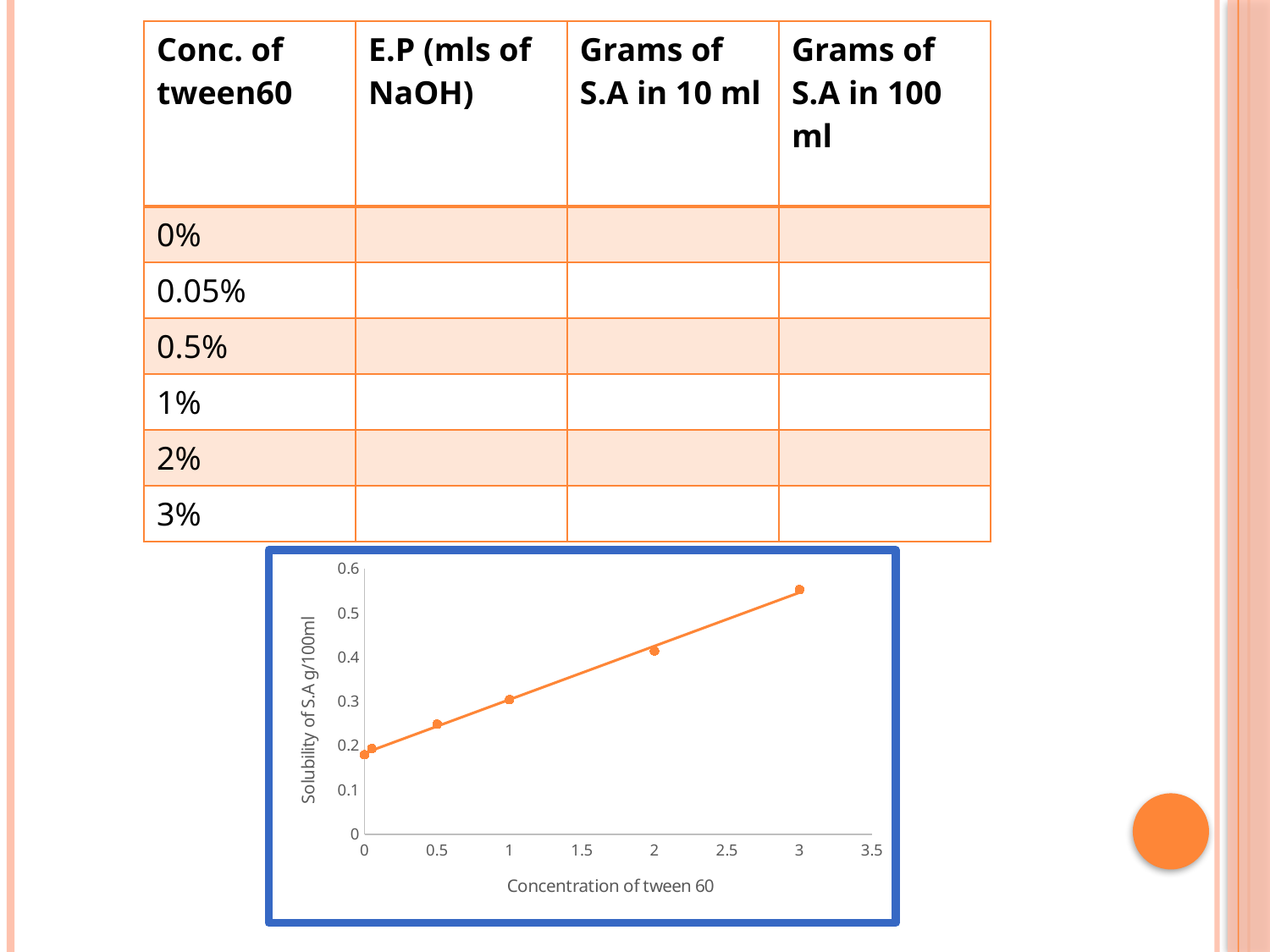
Is the solubility value at a tween 60 concentration of 3 greater or less than 0.5? greater Is the solubility value at a tween 60 concentration of 1 greater or less than 0.4? less Which has the larger solubility value: the point at concentration 2 or the point at concentration 3? 3 How many data points are plotted on the chart? 6 Is the solubility value at a tween 60 concentration of 2 greater or less than 0.5? less What is the label of the vertical axis of the chart? Solubility of S.A g/100ml At which concentration of tween 60 is the plotted solubility highest? 3 Do the plotted solubility values rise or fall as the concentration of tween 60 increases? rise What is the label of the horizontal axis of the chart? Concentration of tween 60 What kind of chart is shown on the slide? scatter chart At which concentration of tween 60 is the plotted solubility lowest? 0